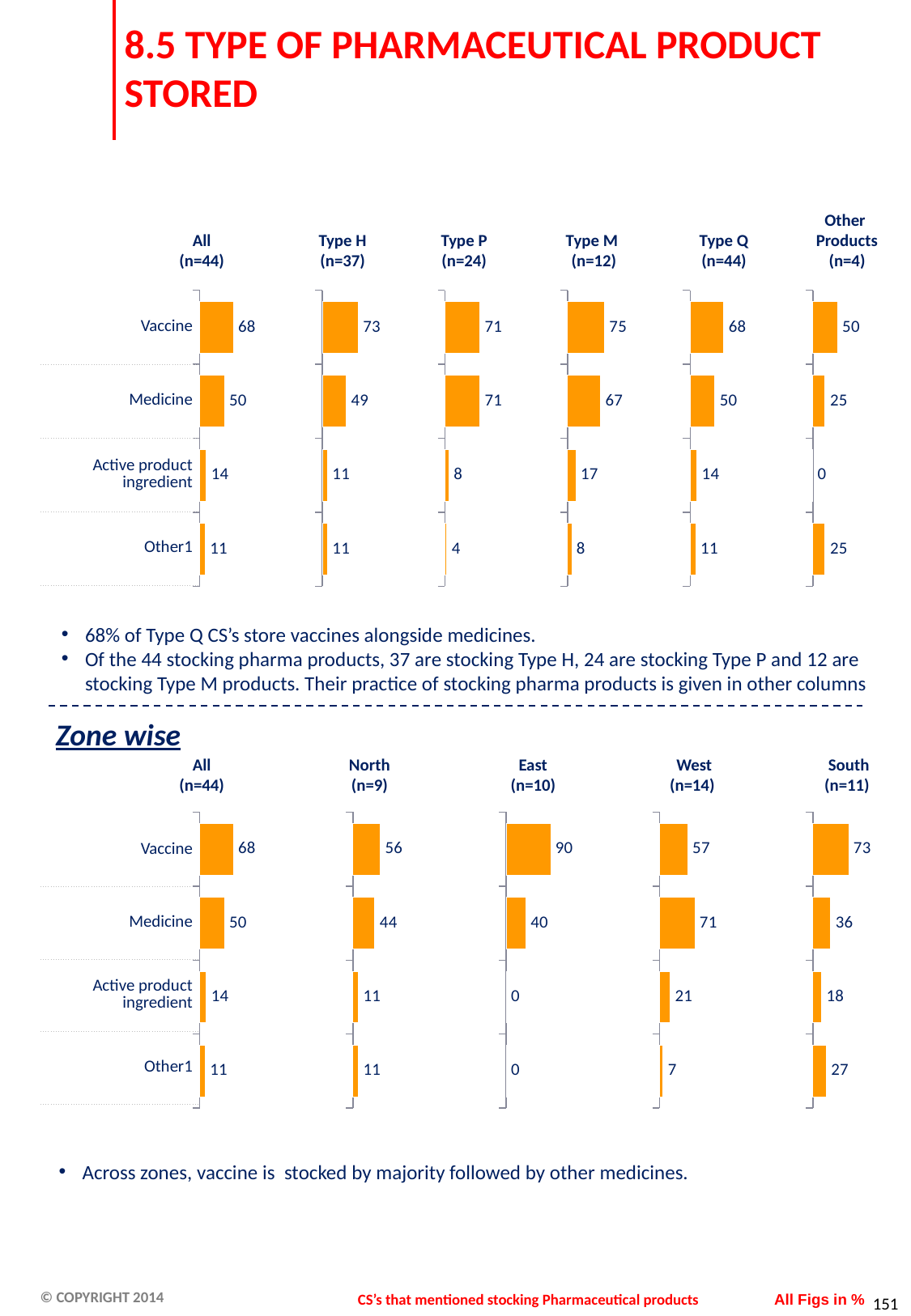
In the top set of charts, which category has the highest value in the Type H (n=37) chart? Vaccine In the top set of charts, what is the value for Medicine in the Other Products (n=4) chart? 25 How many categories are shown in each of the Zone wise charts? 4 In the Zone wise charts, what is the value for Medicine in the West (n=14) chart? 71 In the top set of charts, what is the difference between Vaccine and Medicine in the All (n=44) chart? 18 In the Zone wise charts, which zone has the highest Vaccine value? East In the top set of charts, what is the value for Vaccine in the Type M (n=12) chart? 75 In the top set of charts, which category has the lowest value in the Type P (n=24) chart? Other1 In the Zone wise charts, what is the value for Vaccine in the East (n=10) chart? 90 In the Zone wise charts, what is the difference between Vaccine and Medicine in the South (n=11) chart? 37 What type of chart is used on this slide? Bar chart In the top set of charts, which is larger: Active product ingredient for Type M or Active product ingredient for Type P? Type M